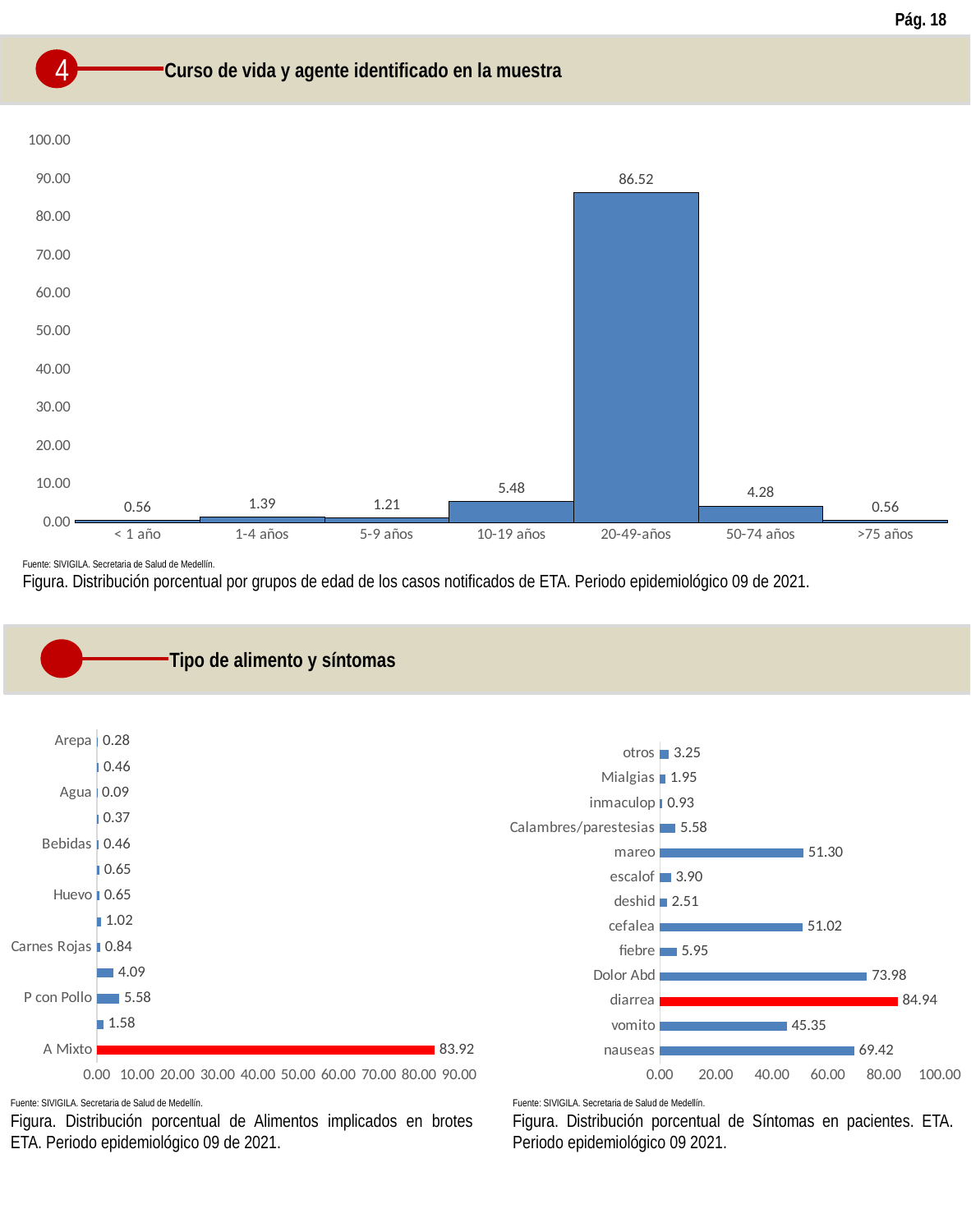
In the top chart (age groups of ETA cases), which is larger, the value for 1-4 años or the value for 5-9 años? 1-4 años In the bottom-left chart (Alimentos implicados), what is the value for A Mixto? 83.92 In the top chart (age groups of ETA cases), what is the value for 20-49-años? 86.52 In the top chart (age groups of ETA cases), how many age groups are shown on the x axis? 7 In the bottom-left chart (Alimentos implicados), what is the value for P con Pollo? 5.58 In the bottom-right chart (Síntomas en pacientes), what is the difference between the values for diarrea and nauseas? 15.52 In the top chart (age groups of ETA cases), what is the value for 10-19 años? 5.48 In the bottom-right chart (Síntomas en pacientes), which symptom has the highest value? diarrea What kind of chart is the top chart (age groups of ETA cases)? Bar chart In the bottom-right chart (Síntomas en pacientes), what is the value for Dolor Abd? 73.98 In the top chart (age groups of ETA cases), what is the difference between the values for 50-74 años and 1-4 años? 2.89 In the top chart (age groups of ETA cases), which age group has the highest value? 20-49-años